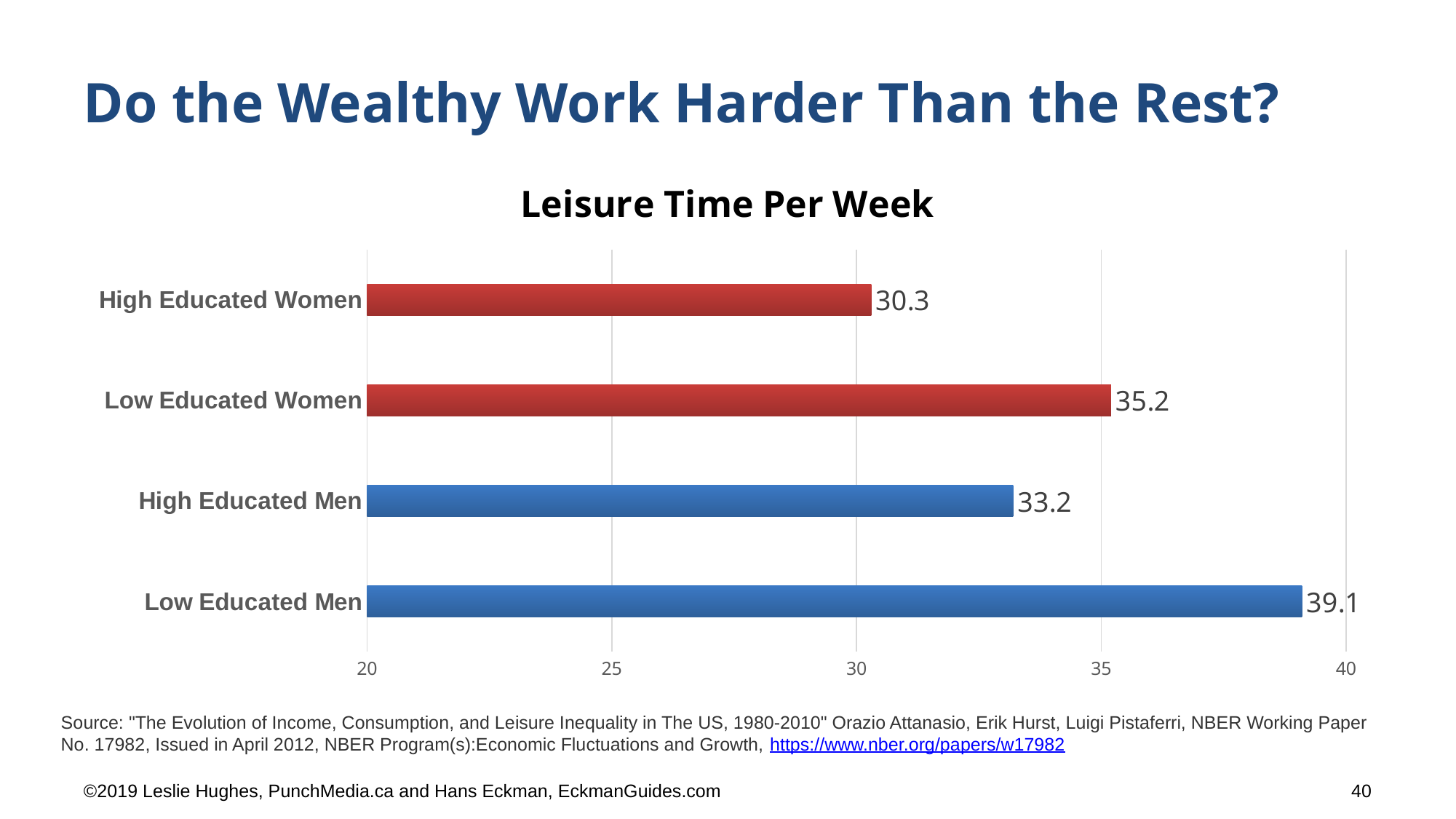
How many categories are shown in the chart? 4 What is the leisure time per week for Low Educated Men? 39.1 What is the leisure time per week for High Educated Men? 33.2 Which category has the highest leisure time per week? Low Educated Men Is the value for High Educated Men greater or less than 35? less Which has more leisure time per week, Low Educated Women or High Educated Men? Low Educated Women What is the leisure time per week for High Educated Women? 30.3 What is the title of the chart? Leisure Time Per Week What kind of chart is shown on the slide? Bar chart Which category has the lowest leisure time per week? High Educated Women What is the difference in leisure time per week between Low Educated Men and High Educated Men? 5.9 What is the difference in leisure time per week between Low Educated Women and High Educated Women? 4.9